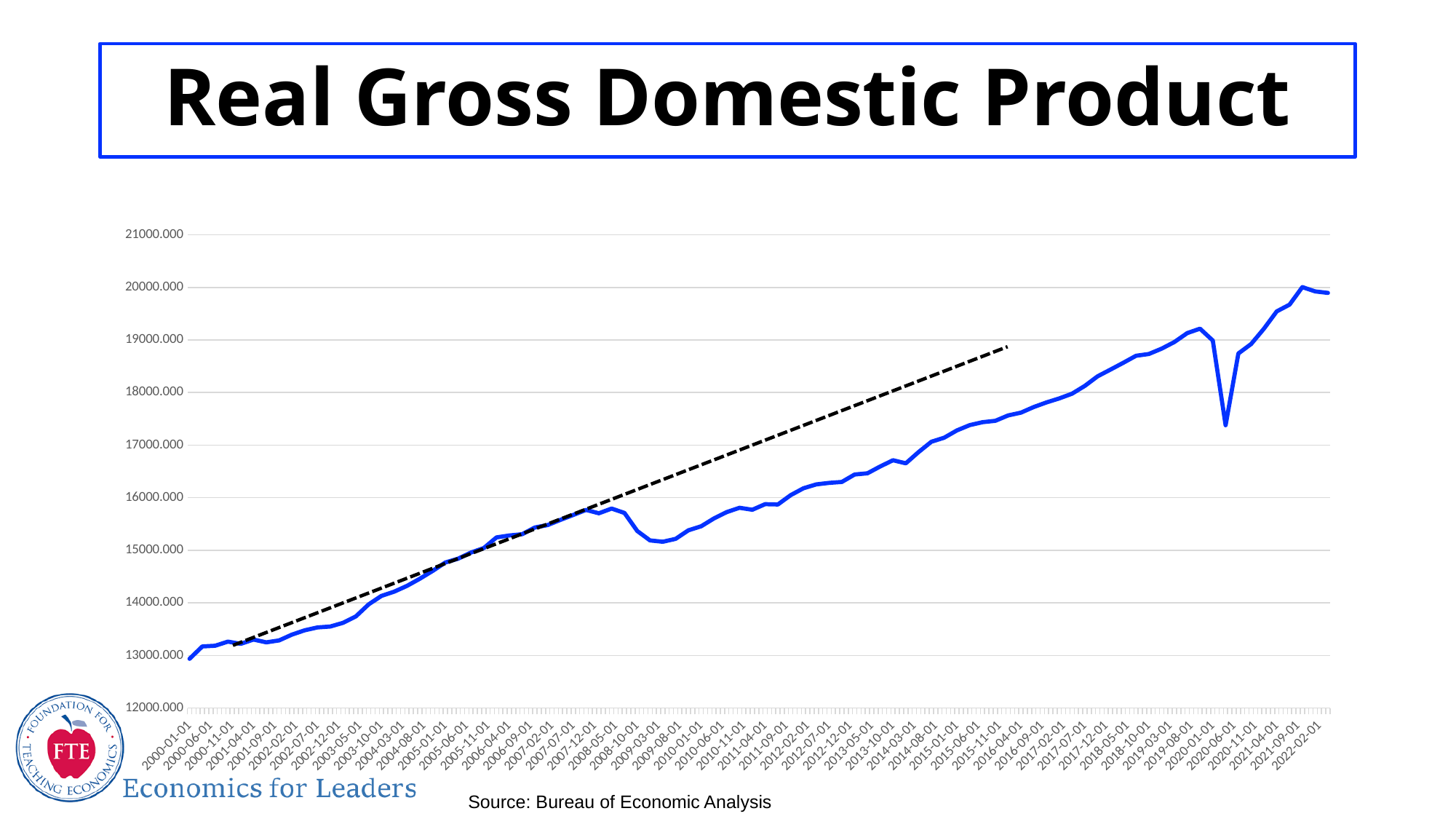
Overall, does Real GDP rise or fall from 2000 to 2022 along the x axis? rise Is the value for 2015-01-01 greater or less than 17000? greater What is the title of the chart on the slide? Real Gross Domestic Product Which is larger, the value for 2008-05-01 or the value for 2009-08-01? 2008-05-01 Which is larger, the value for 2019-08-01 or the value for 2020-06-01? 2019-08-01 What kind of chart is shown on the slide? line chart What source is cited for the chart data? Bureau of Economic Analysis Is the value for 2022-02-01 greater or less than 19000? greater Is the value for 2009-03-01 greater or less than 16000? less